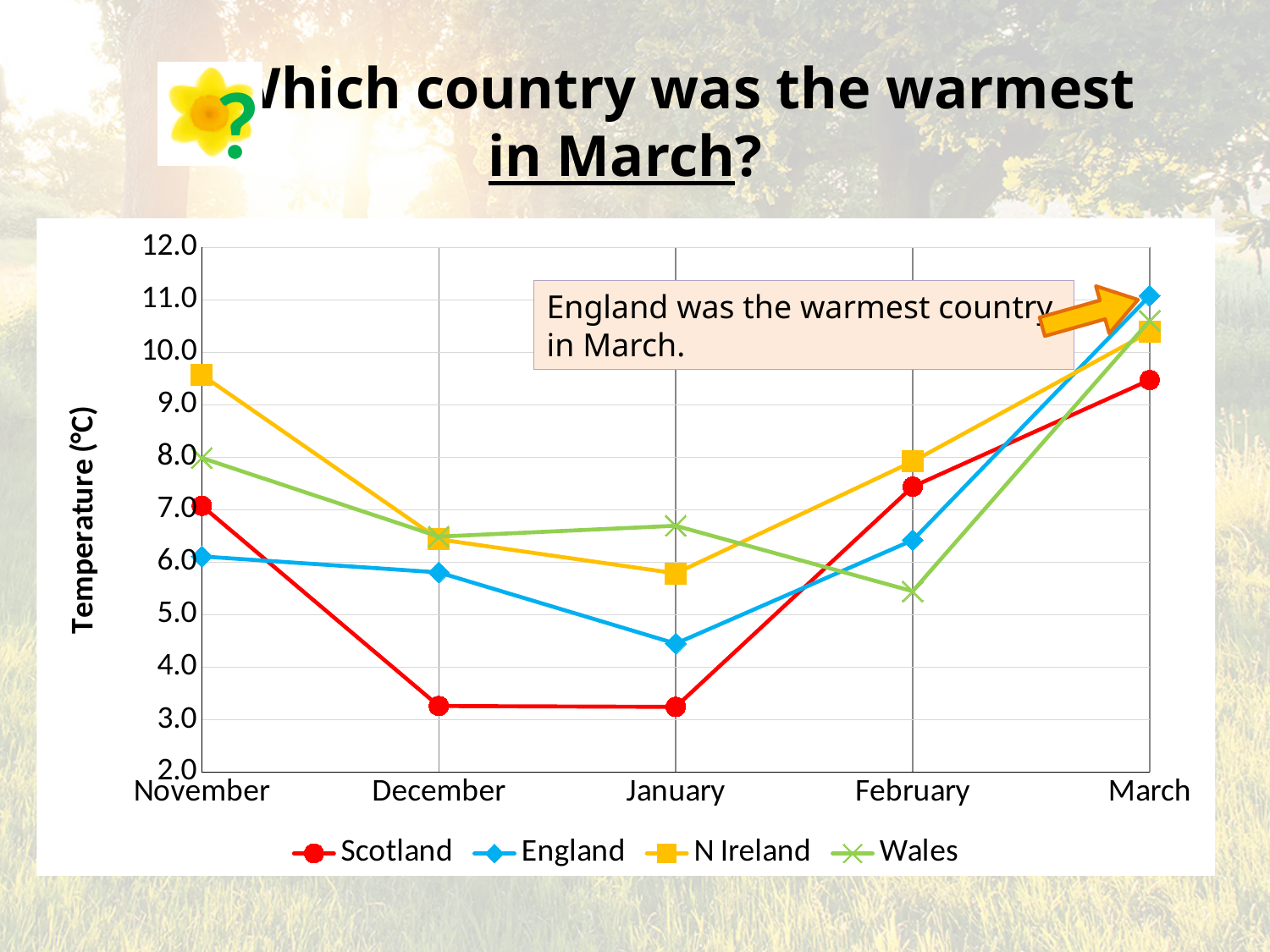
Does the temperature for Scotland rise or fall from January to March? rise Is the temperature for N Ireland in November greater or less than 9.0? greater Which country had the lowest temperature in January? Scotland What is the label on the vertical axis? Temperature (°C) How many series does the legend list? 4 Which country had the highest temperature in March? England Which is higher in December, Scotland or England? England What kind of chart is shown on the slide? line chart Is the temperature for Scotland in December greater or less than 4.0? less Which country had the lowest temperature in March? Scotland Which country had the highest temperature in November? N Ireland How many months are shown on the x axis? 5